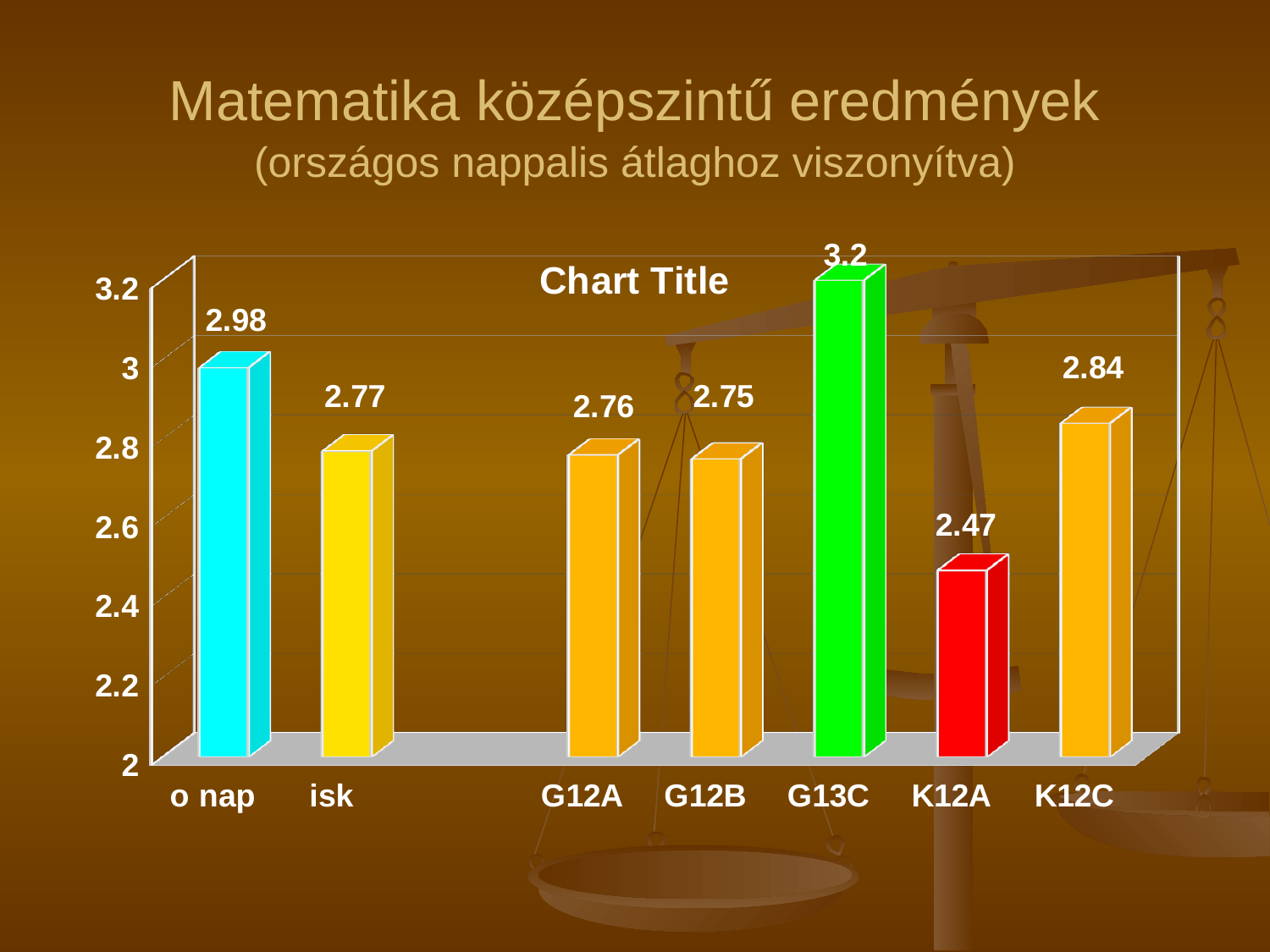
What kind of chart is shown on the slide? bar chart Which is larger, the value for K12C or the value for isk? K12C Which category has the highest value? G13C How many labeled bars are shown in the chart? 7 What is the difference between the values for o nap and isk? 0.21 What is the difference between the values for G13C and K12A? 0.73 What is the value for G13C? 3.2 Is the value for K12A greater or less than 2.6? less What is the value for K12A? 2.47 What is the value for K12C? 2.84 What is the value for o nap? 2.98 Which category has the lowest value? K12A